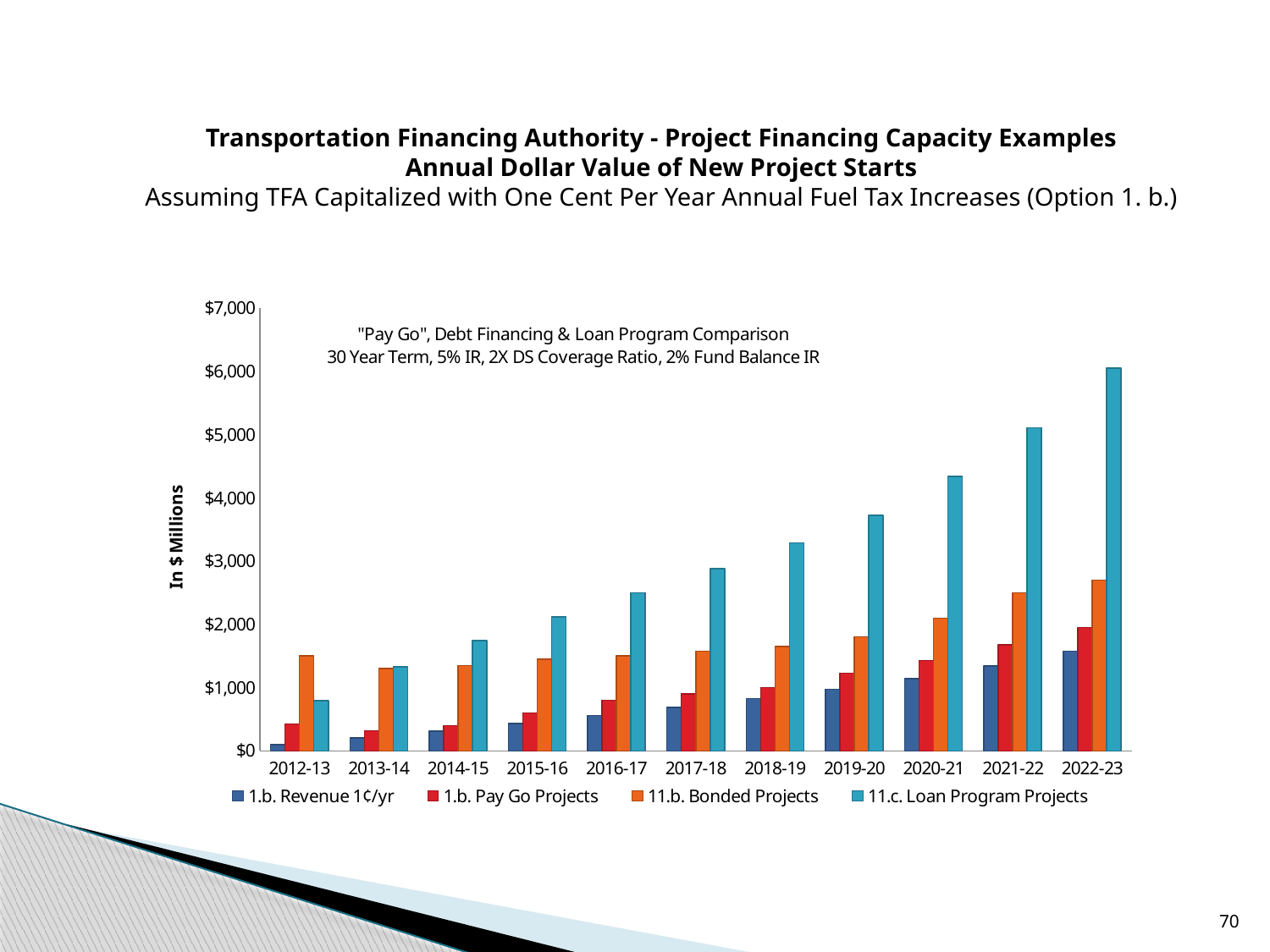
Is the value for 11.b. Bonded Projects in 2012-13 greater or less than $1,000? greater Is the value for 11.c. Loan Program Projects in 2020-21 greater or less than $4,000? greater How many fiscal years are shown along the x axis? 11 In 2022-23, which is larger: 11.c. Loan Program Projects or 11.b. Bonded Projects? 11.c. Loan Program Projects In 2012-13, which is larger: 11.b. Bonded Projects or 11.c. Loan Program Projects? 11.b. Bonded Projects How many series does the legend list? 4 Which series has the lowest value in 2012-13? 1.b. Revenue 1¢/yr Do the values for 11.c. Loan Program Projects rise or fall from 2012-13 to 2022-23? rise What kind of chart is shown on the slide? bar chart What is the title of the vertical axis? In $ Millions Is the value for 1.b. Revenue 1¢/yr in 2012-13 greater or less than $1,000? less In which year is the value for 11.c. Loan Program Projects highest? 2022-23